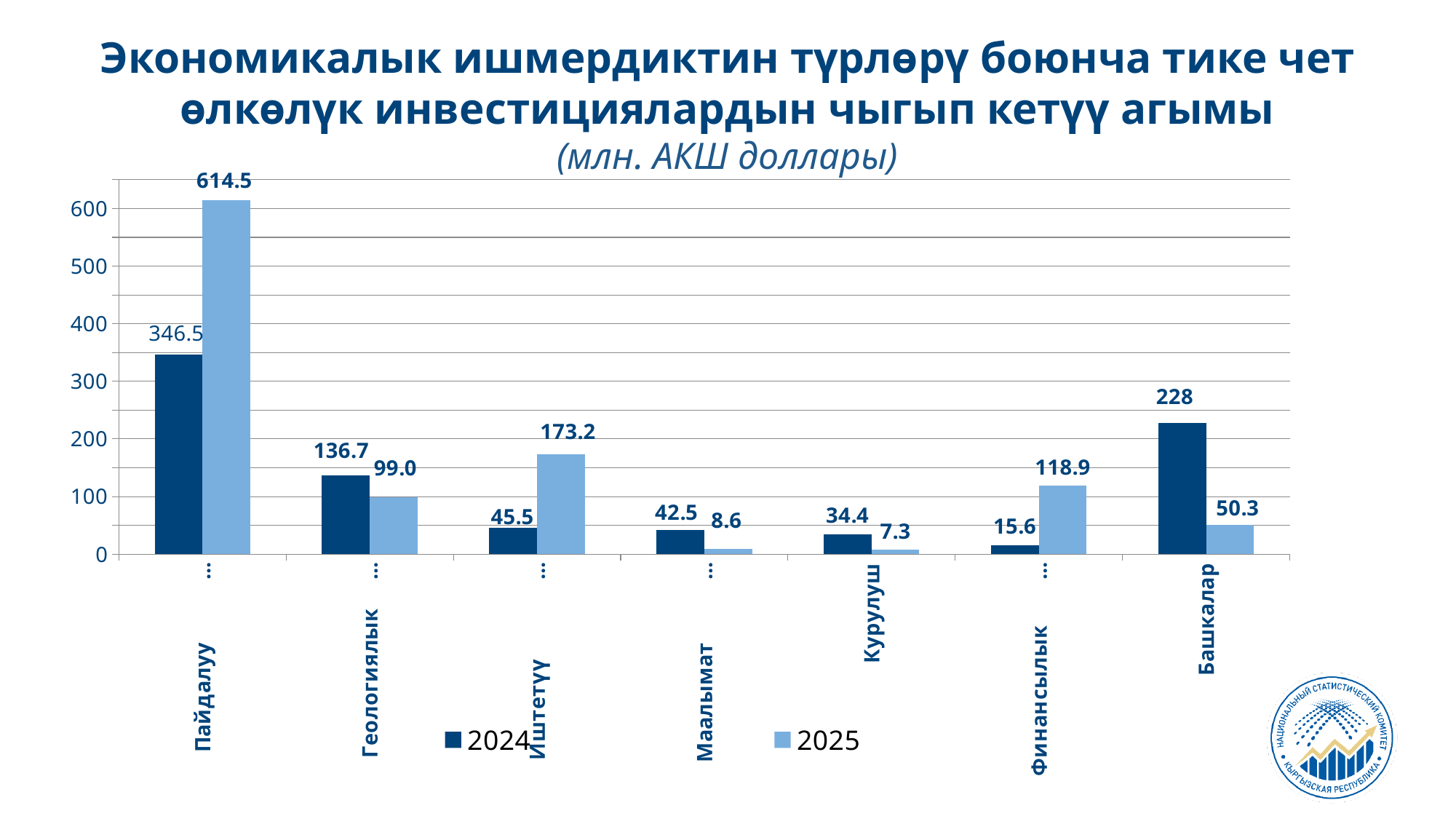
What kind of chart is shown on the slide? Bar chart What is the 2025 value for Пайдалуу? 614.5 What is the 2024 value for Курулуш? 34.4 How many series does the legend list? 2 Which is larger for Иштетүү, the 2024 value or the 2025 value? 2025 Which category has the lowest 2025 value? Курулуш How many categories are shown on the x axis? 7 Is the 2024 value for Геологиялык greater or less than 100? greater Which category has the highest 2024 value? Пайдалуу What is the 2024 value for Башкалар? 228 What is the 2025 value for Финансылык? 118.9 What is the difference between the 2025 and 2024 values for Пайдалуу? 268